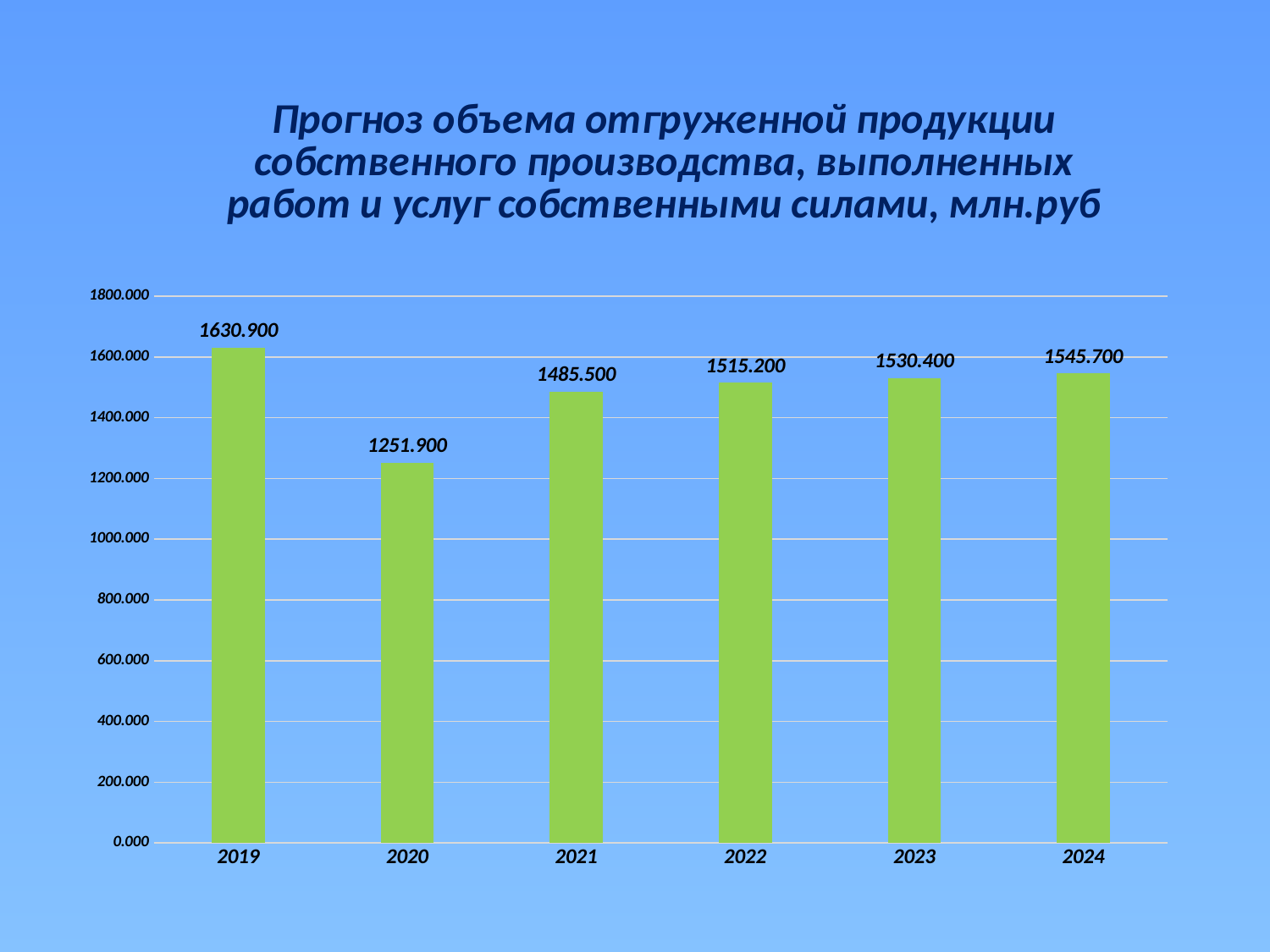
What is the difference between the values for 2024 and 2021? 60.200 Which year has the highest value? 2019 What is the value for 2020? 1251.900 What is the value for 2024? 1545.700 Which year has the lowest value? 2020 What is the value for 2019? 1630.900 Is the value for 2020 greater or less than 1400.000? less How many years are shown on the x axis? 6 Do the values rise or fall from 2021 to 2024? rise Which is larger, the value for 2022 or the value for 2023? 2023 What is the difference between the values for 2019 and 2020? 379.000 What kind of chart is shown on the slide? bar chart